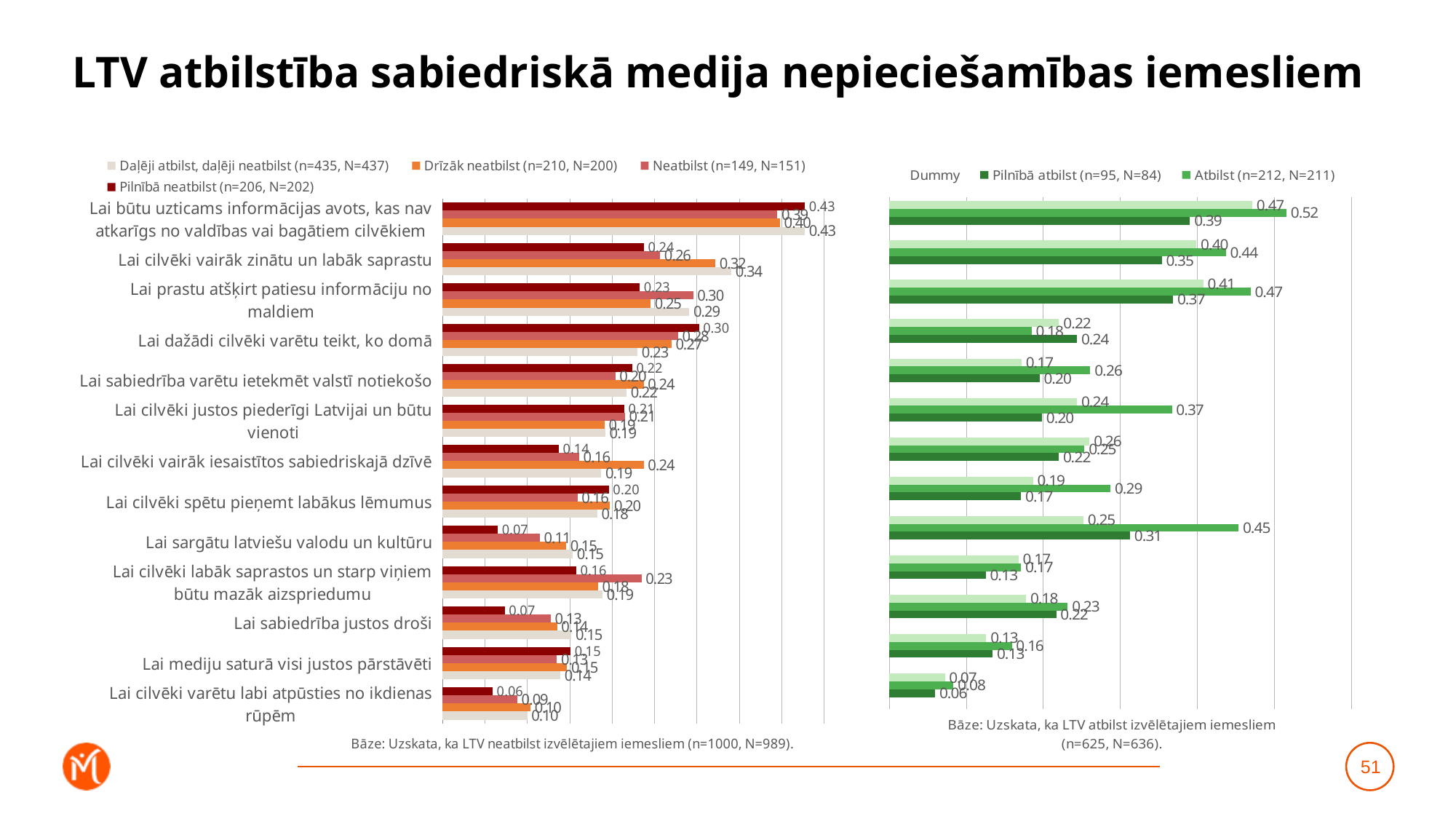
In the left chart, how many categories are listed? 13 In the right chart, what is the 'Pilnībā atbilst' value for the row 'Lai sargātu latviešu valodu un kultūru'? 0.31 In the left chart, what is the value of 'Drīzāk neatbilst' for 'Lai cilvēki vairāk zinātu un labāk saprastu'? 0.32 What is the base (Bāze) stated under the left chart? Uzskata, ka LTV neatbilst izvēlētajiem iemesliem (n=1000, N=989) In the right chart, what is the 'Atbilst' value for the top row ('Lai būtu uzticams informācijas avots, kas nav atkarīgs no valdības vai bagātiem cilvēkiem')? 0.52 In the left chart, what is the value of 'Pilnībā neatbilst' for 'Lai būtu uzticams informācijas avots, kas nav atkarīgs no valdības vai bagātiem cilvēkiem'? 0.43 In the left chart, what is the difference between the 'Drīzāk neatbilst' value (0.24) and the 'Pilnībā neatbilst' value (0.14) for 'Lai cilvēki vairāk iesaistītos sabiedriskajā dzīvē'? 0.10 In the right chart, for the row 'Lai cilvēki justos piederīgi Latvijai un būtu vienoti', which is larger: the 'Atbilst' value or the 'Pilnībā atbilst' value? Atbilst In the left chart, which category has the lowest 'Pilnībā neatbilst' value? Lai cilvēki varētu labi atpūsties no ikdienas rūpēm What type of chart is shown on the right side of the slide? Bar chart In the left chart, how many series does the legend list? 4 In the left chart, what is the value of 'Pilnībā neatbilst' for 'Lai sargātu latviešu valodu un kultūru'? 0.07